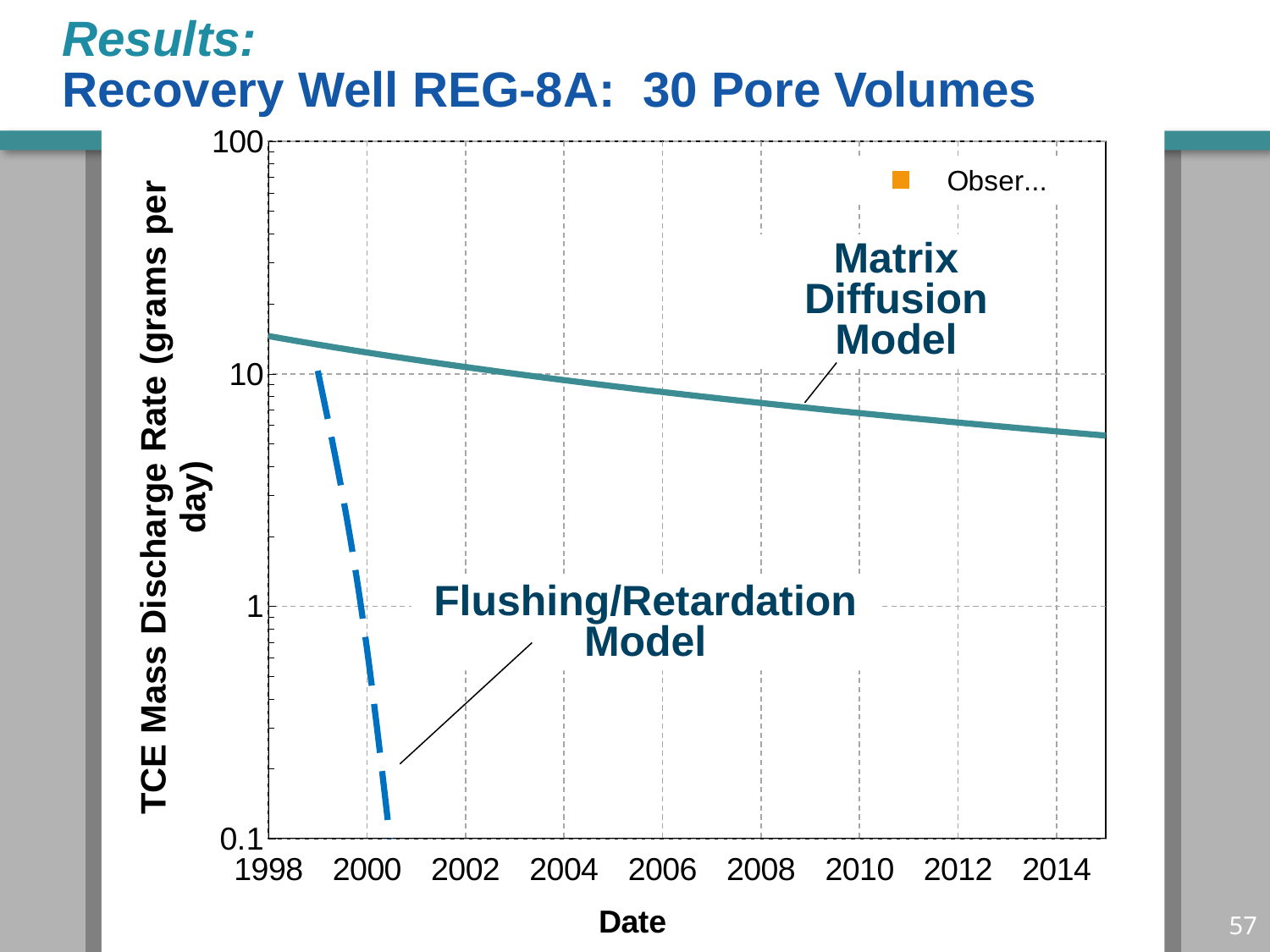
Does the Matrix Diffusion Model curve rise or fall from 1998 to 2014? fall Which model curve is drawn as a dashed line? Flushing/Retardation Model Which model has the higher TCE mass discharge rate in 2000, the Matrix Diffusion Model or the Flushing/Retardation Model? Matrix Diffusion Model What is the label of the x axis? Date What kind of chart is shown on the slide? line chart Does the Flushing/Retardation Model curve rise or fall over time? fall Is the value of the Matrix Diffusion Model in 2014 greater or less than 10 grams per day? less Which of the two model curves falls more steeply over time? Flushing/Retardation Model Is the value of the Matrix Diffusion Model in 2006 greater or less than 100 grams per day? less Is the value of the Matrix Diffusion Model in 2014 greater or less than 1 gram per day? greater